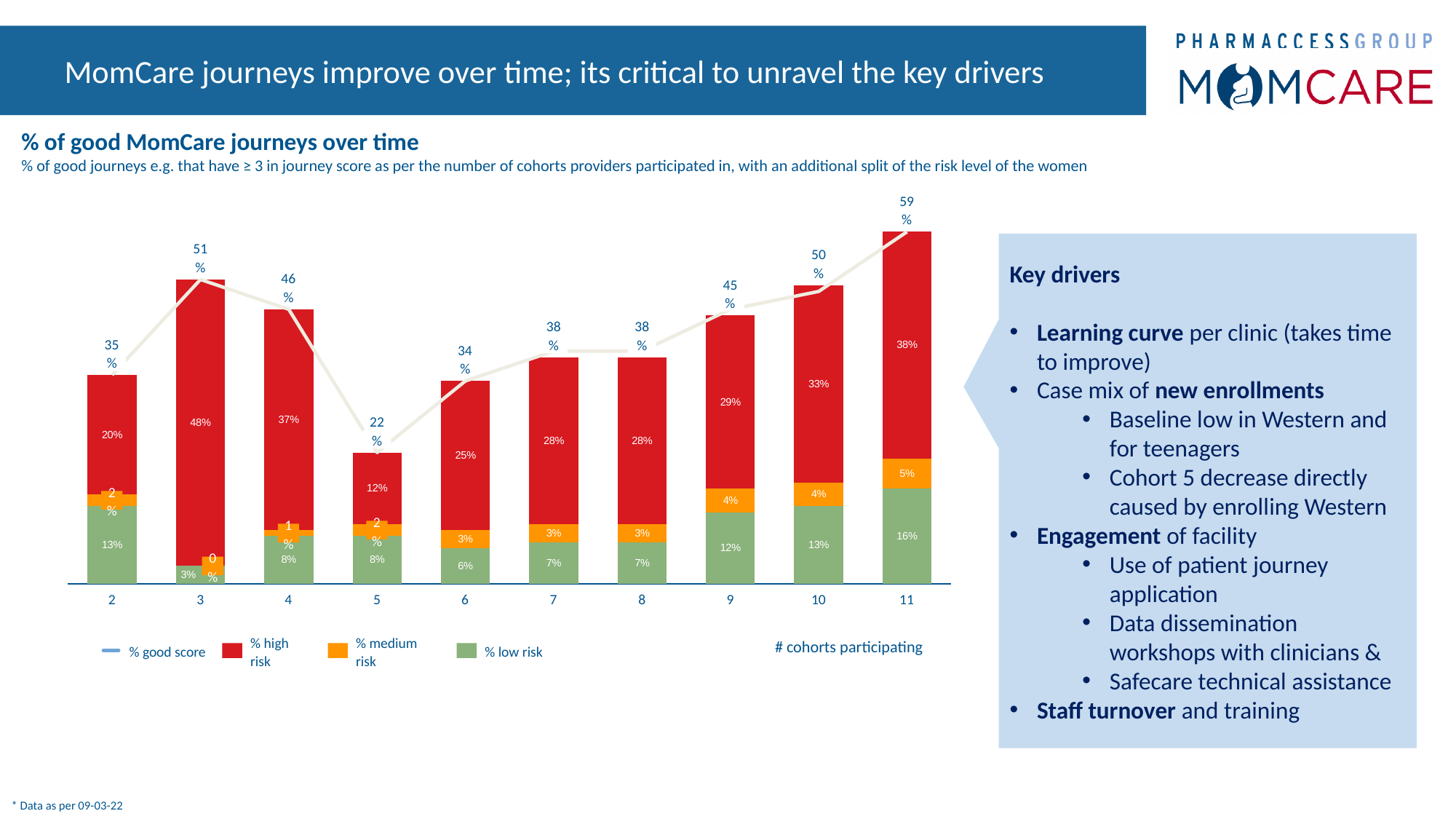
What kind of chart is used to show the risk-level split? Stacked bar chart (with a line for % good score) What is the % high risk value for 3 cohorts participating? 48% At which number of cohorts participating is the % good score highest? 11 Does the % good score rise or fall from 5 cohorts to 11 cohorts participating? Rise How many series does the legend list? 4 At which number of cohorts participating is the % good score lowest? 5 What is the total of the stacked bar for 9 cohorts participating (high, medium and low risk combined)? 45% What is the % low risk value for 10 cohorts participating? 13% Which has a larger % high risk value: 4 cohorts participating or 6 cohorts participating? 4 What is the % good score for 11 cohorts participating? 59% What is the difference between the % good score at 11 cohorts and at 5 cohorts? 37% How many categories (numbers of cohorts participating) are shown on the x axis? 10